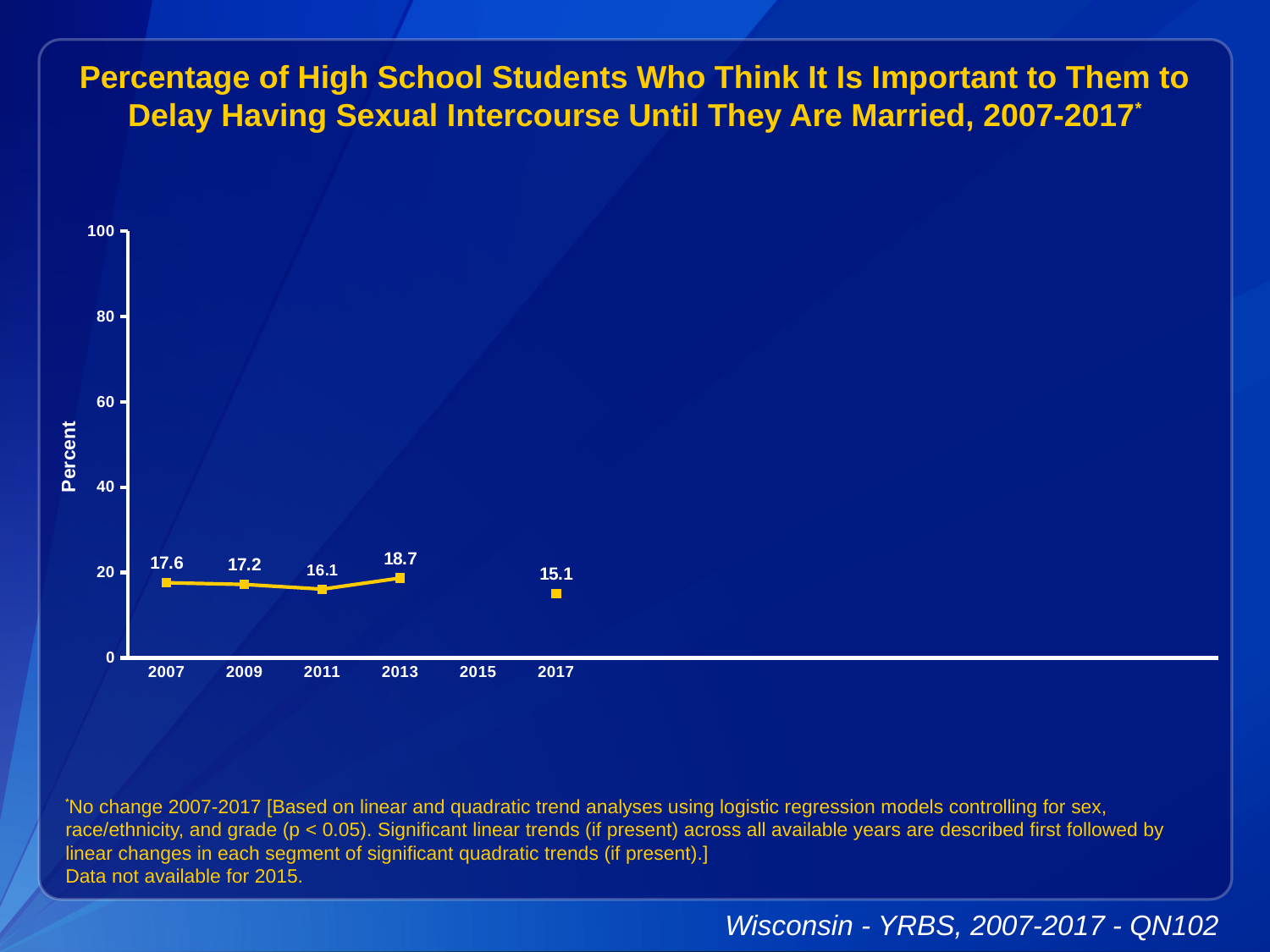
Which is larger, the value for 2009 or the value for 2017? 2009 How many years have a plotted data point? 5 What kind of chart is this? line chart Is the value for 2013 greater or less than 20? less Do the values rise or fall from 2007 to 2011? fall Which year has the lowest value? 2017 What is the label on the y axis? Percent Which year has the highest value? 2013 What is the value for 2011? 16.1 What is the value for 2017? 15.1 What is the difference between the values for 2013 and 2011? 2.6 What is the value for 2007? 17.6